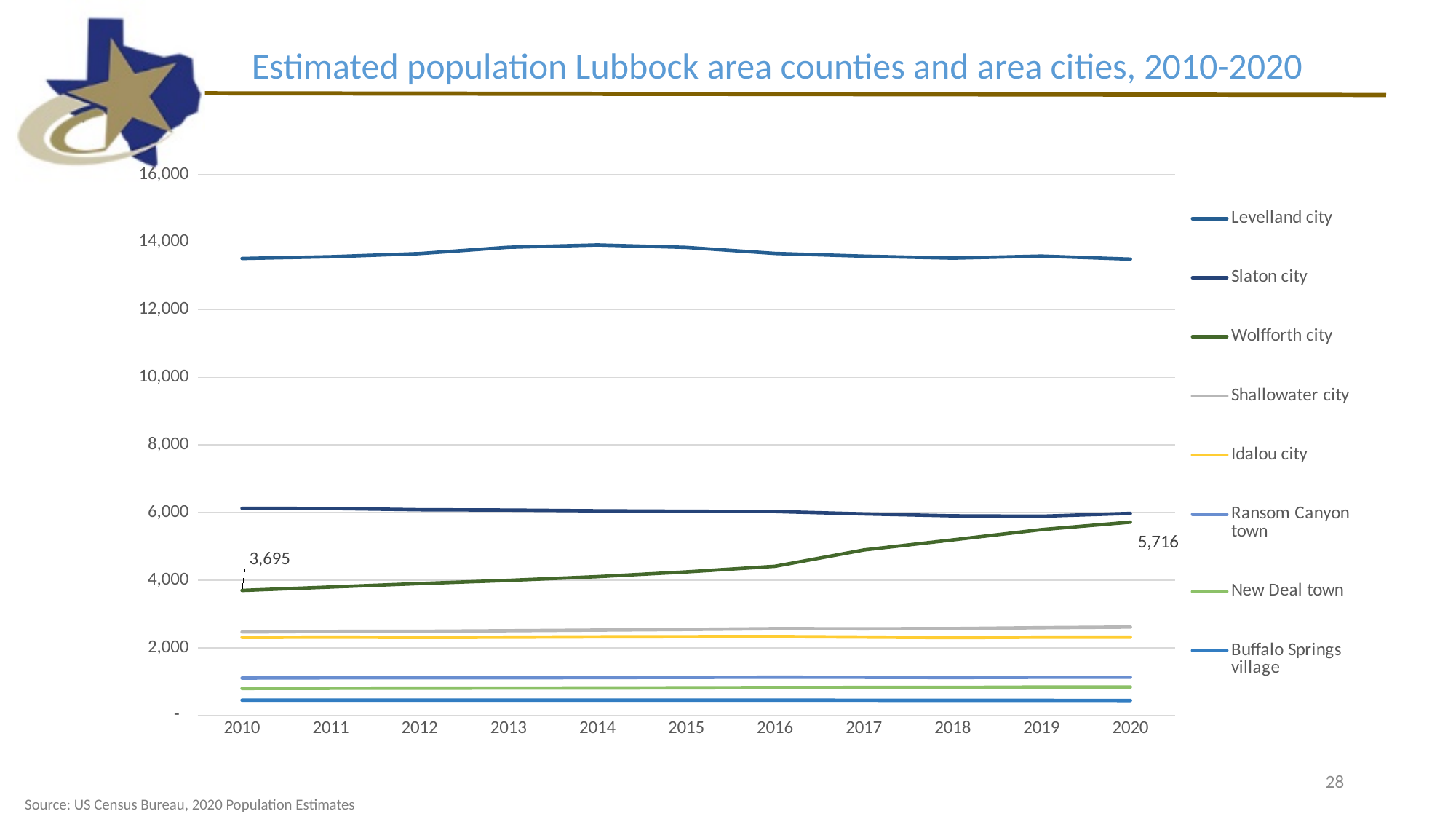
In 2010, which is larger: Slaton city or Wolfforth city? Slaton city Which series has the lowest values across the chart? Buffalo Springs village Is the value for Levelland city in 2014 greater or less than 12,000? greater By how much did the Wolfforth city value increase from 2010 to 2020, using the printed labels? 2,021 What is the title of the chart? Estimated population Lubbock area counties and area cities, 2010-2020 Does the Wolfforth city line rise or fall from 2010 to 2020? Rises What is the labelled value for Wolfforth city in 2020? 5,716 How many series does the legend list? 8 What is the labelled value for Wolfforth city in 2010? 3,695 What kind of chart is shown on the slide? Line chart Which series has the highest values across the chart? Levelland city How many years are shown along the x axis? 11